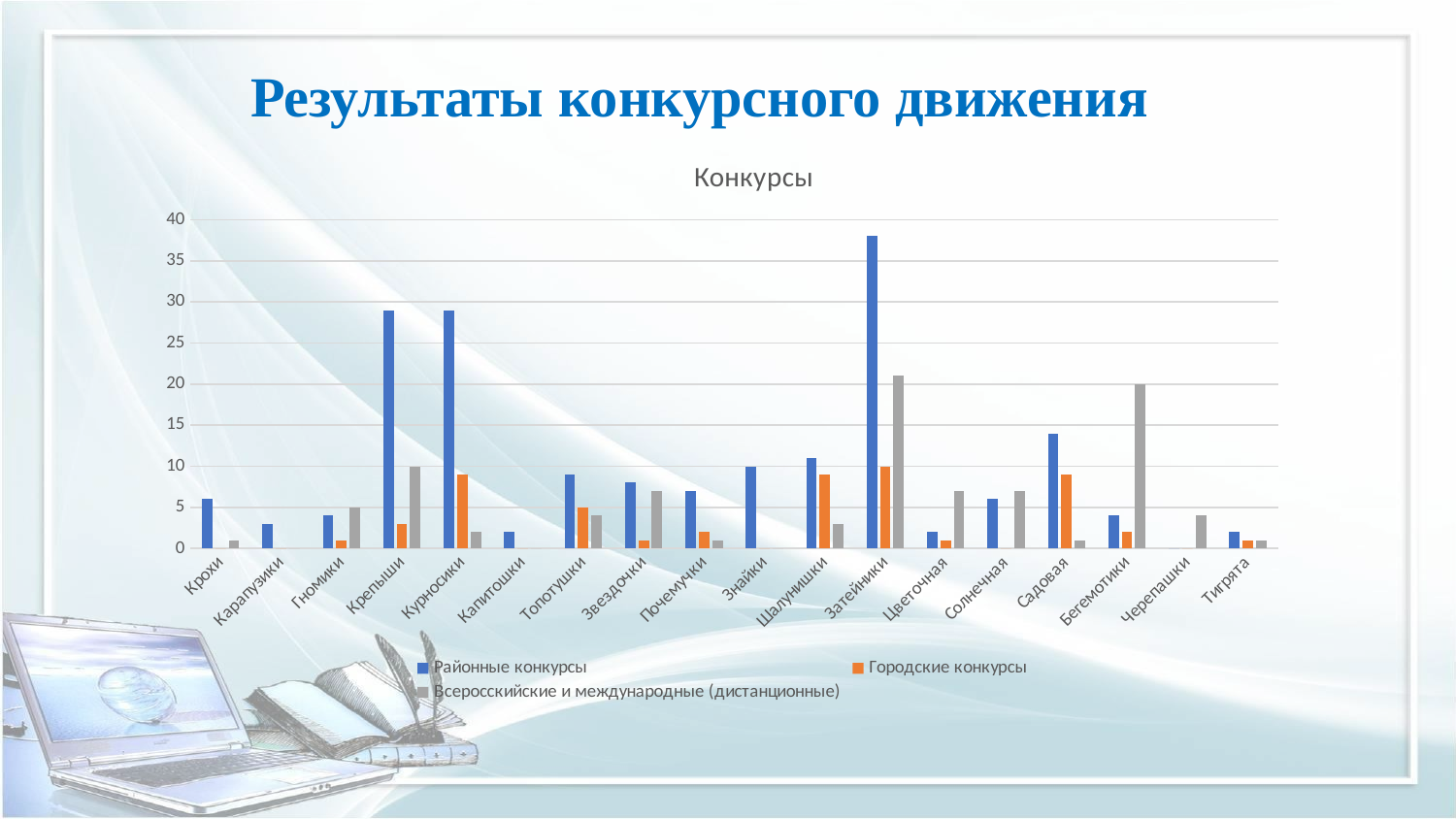
Which category has the highest value for Районные конкурсы? Затейники Which is larger: the Районные конкурсы value for Затейники or for Садовая? Затейники Is the value for Всероссийские и международные (дистанционные) for Бегемотики greater or less than 15? greater Which colour represents Городские конкурсы in the legend? orange Is the value for Районные конкурсы for Крепыши greater or less than 25? greater How many series does the legend list? 3 How many categories are shown on the x axis? 18 Is the value for Районные конкурсы for Садовая greater or less than 10? greater What is the title of the chart? Конкурсы What kind of chart is shown on the slide? bar chart Which is larger: the Районные конкурсы value for Крохи or for Курносики? Курносики